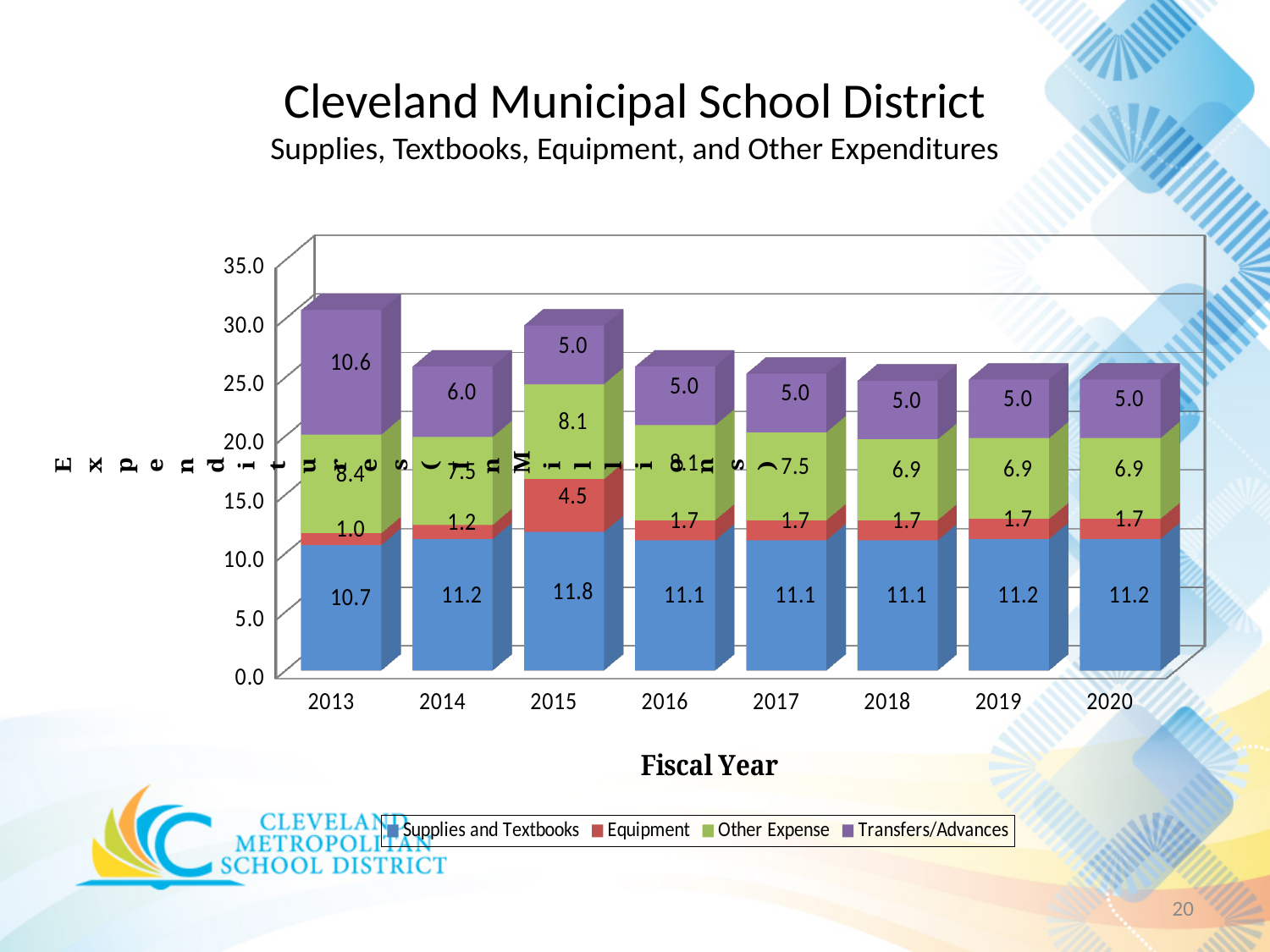
What kind of chart is shown on the slide? Stacked bar chart What is the value for Equipment in fiscal year 2015? 4.5 How many fiscal years are shown on the x axis? 8 Which fiscal year has the highest Transfers/Advances value? 2013 What is the total of the stacked bar for fiscal year 2018? 24.7 Which fiscal year has the highest Equipment value? 2015 What is the title of the x axis? Fiscal Year How many series does the legend list? 4 What is the difference between the Transfers/Advances values for 2013 and 2014? 4.6 Which is larger, the Supplies and Textbooks value for 2015 or for 2013? 2015 What is the value for Supplies and Textbooks in fiscal year 2015? 11.8 What is the value for Transfers/Advances in fiscal year 2013? 10.6